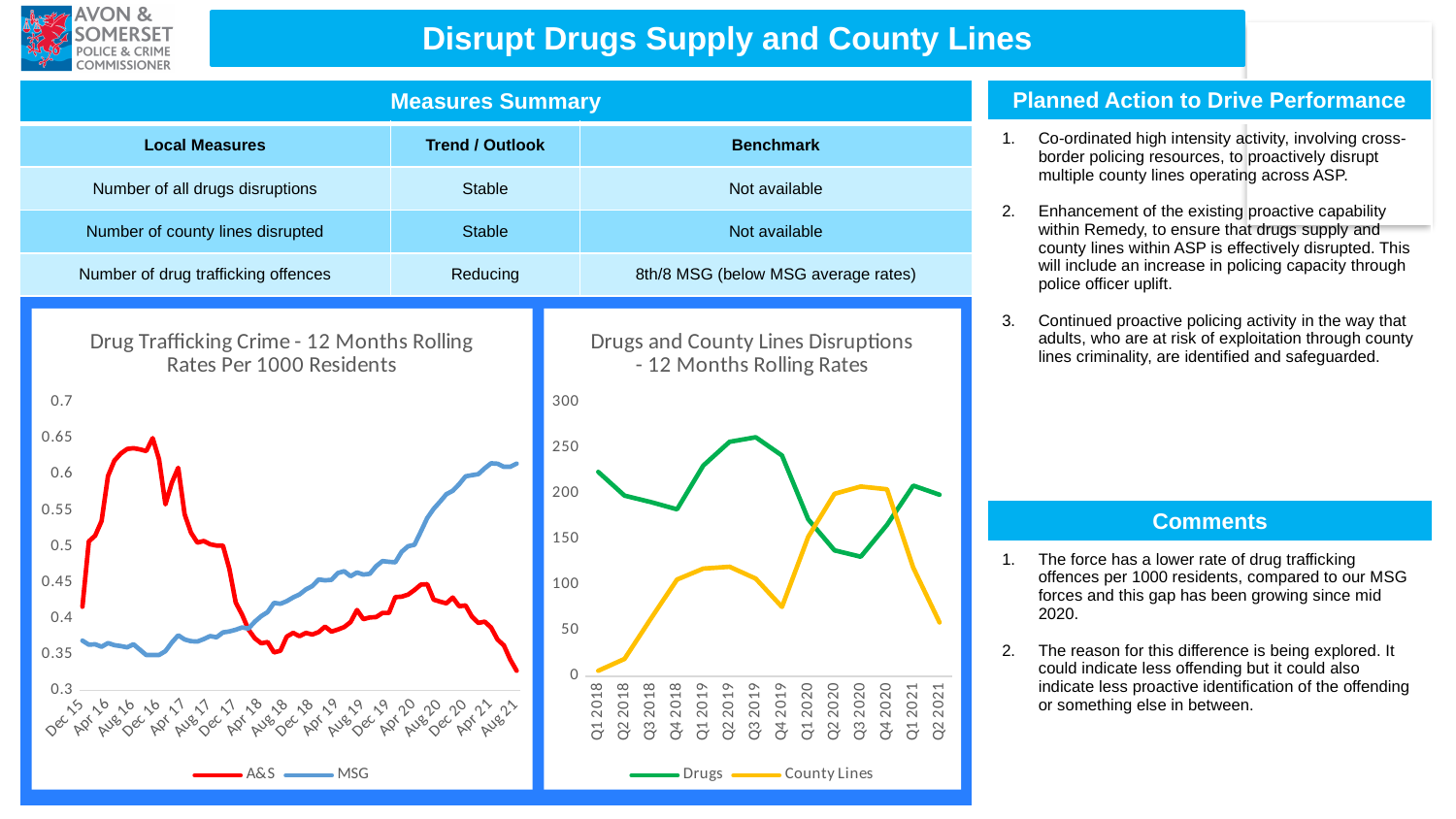
In the 'Drugs and County Lines Disruptions - 12 Months Rolling Rates' chart, which series has the higher value at Q3 2020, Drugs or County Lines? County Lines What kind of chart is the 'Drug Trafficking Crime - 12 Months Rolling Rates Per 1000 Residents' chart? Line chart In the 'Drug Trafficking Crime - 12 Months Rolling Rates Per 1000 Residents' chart, which series has the higher value at Aug 16, A&S or MSG? A&S In the 'Drug Trafficking Crime - 12 Months Rolling Rates Per 1000 Residents' chart, does the MSG series generally rise or fall from Dec 15 to Aug 21? Rise In the 'Drugs and County Lines Disruptions - 12 Months Rolling Rates' chart, what colour is the County Lines line? Yellow What kind of chart is the 'Drugs and County Lines Disruptions - 12 Months Rolling Rates' chart? Line chart In the 'Drug Trafficking Crime - 12 Months Rolling Rates Per 1000 Residents' chart, is the A&S value at Aug 21 greater or less than 0.35? less How many series does the legend of the 'Drug Trafficking Crime - 12 Months Rolling Rates Per 1000 Residents' chart list? 2 In the 'Drugs and County Lines Disruptions - 12 Months Rolling Rates' chart, is the Drugs value at Q3 2019 greater or less than 250? greater In the 'Drugs and County Lines Disruptions - 12 Months Rolling Rates' chart, is the County Lines value at Q1 2018 greater or less than 50? less How many quarters are shown on the x axis of the 'Drugs and County Lines Disruptions - 12 Months Rolling Rates' chart? 14